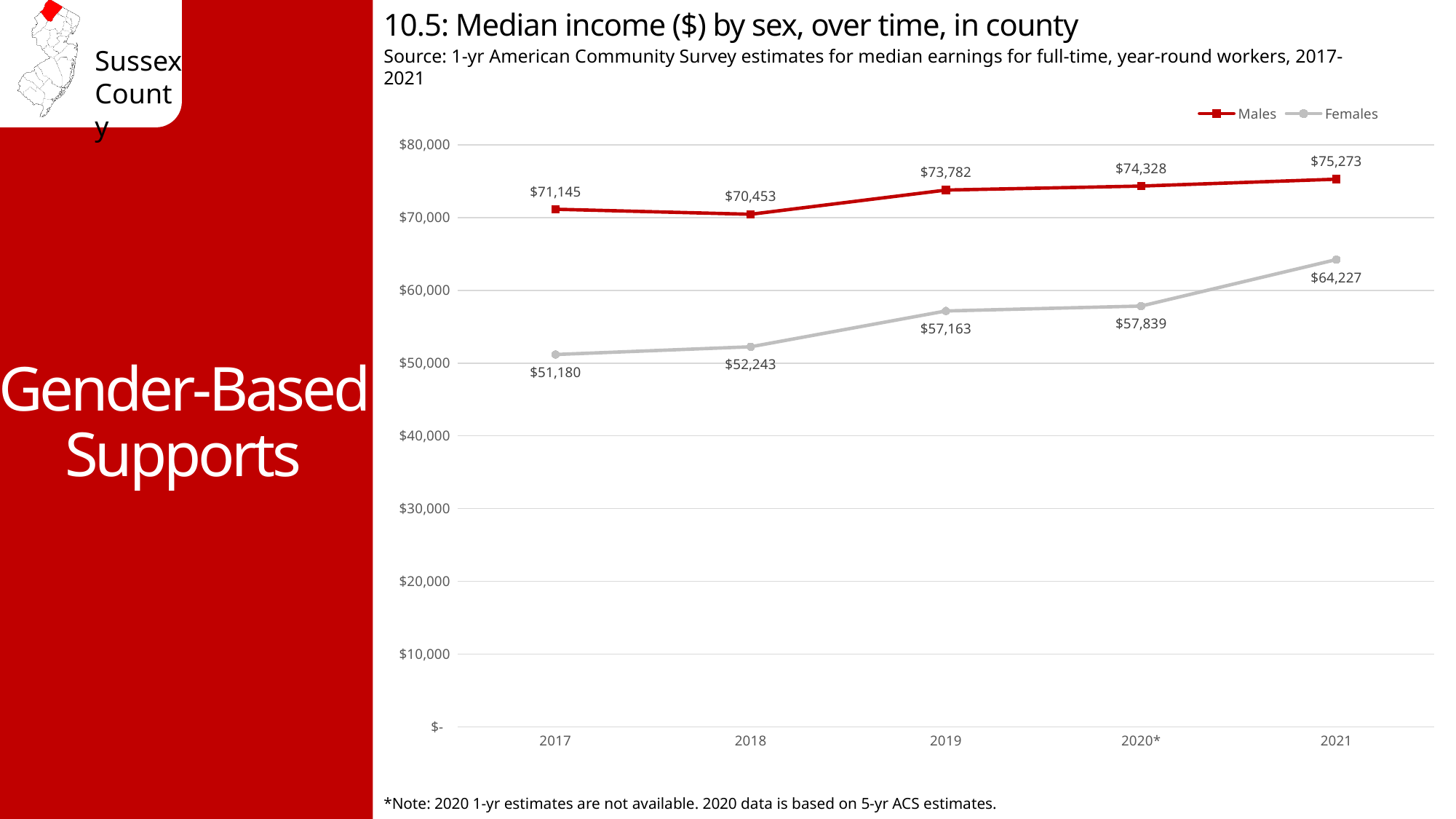
What was the median income for males in 2019? $73,782 In which year was the median income for males lowest? 2018 How many years are shown on the x axis? 5 Is the median income for females in 2021 greater or less than $60,000? greater How many series does the legend list? 2 What kind of chart is shown on the slide? Line chart In which year was the median income for females highest? 2021 What was the median income for females in 2017? $51,180 What was the median income for females in 2021? $64,227 What is the difference between female median income in 2020* and 2019? $676 Which was higher in 2018, the median income for males or for females? Males What is the difference between male and female median income in 2021? $11,046